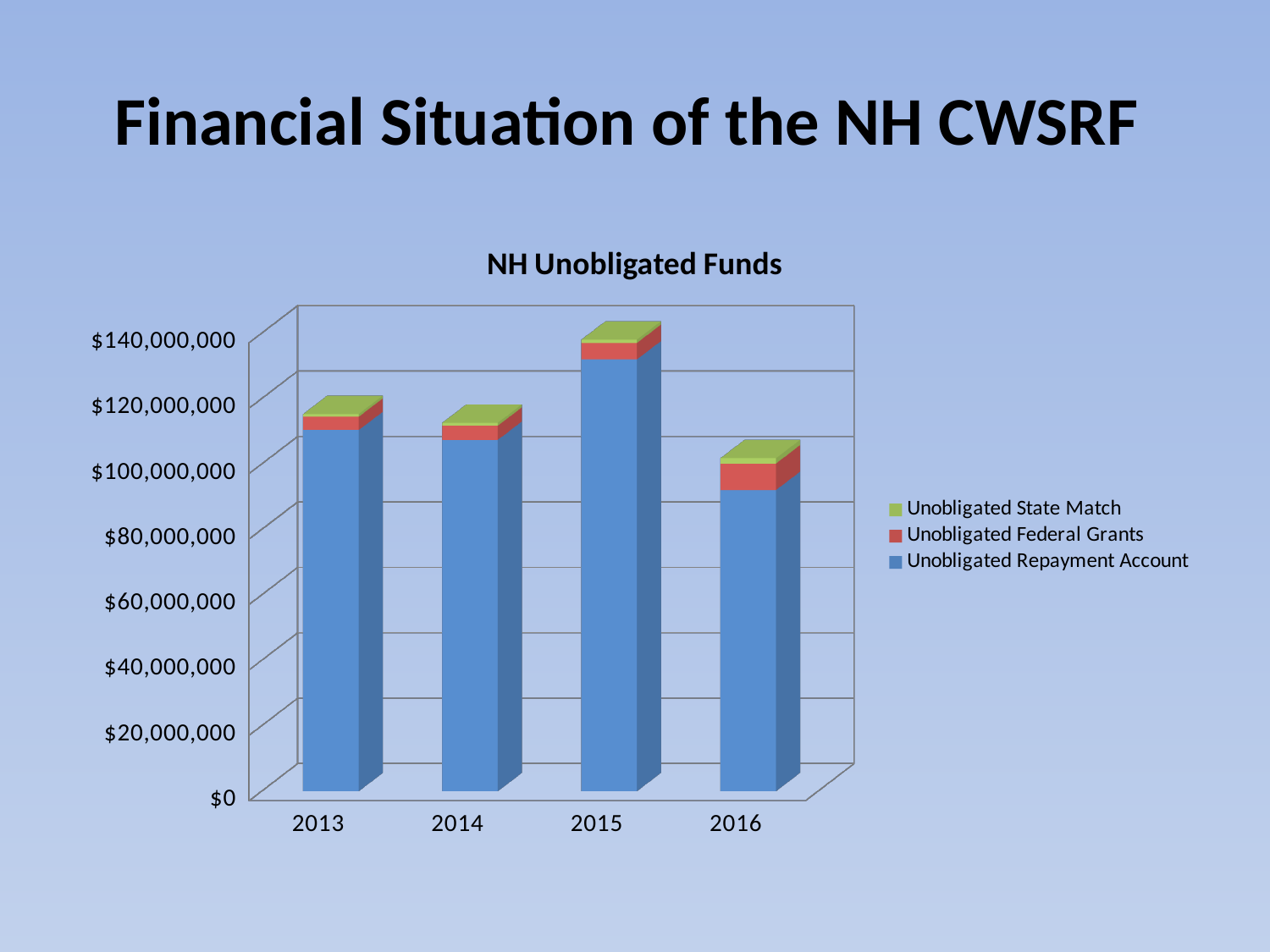
Which year has the lowest total unobligated funds? 2016 Is the total for 2015 greater or less than $120,000,000? greater Is the Unobligated Repayment Account value for 2016 greater or less than $100,000,000? less How many series does the legend list? 3 Which year has the larger total, 2015 or 2016? 2015 Does the total rise or fall from 2015 to 2016? fall What kind of chart is shown on the slide? bar chart What is the title of the chart? NH Unobligated Funds How many years are shown on the x axis? 4 Which year has the highest total unobligated funds? 2015 Is the total for 2016 greater or less than $120,000,000? less